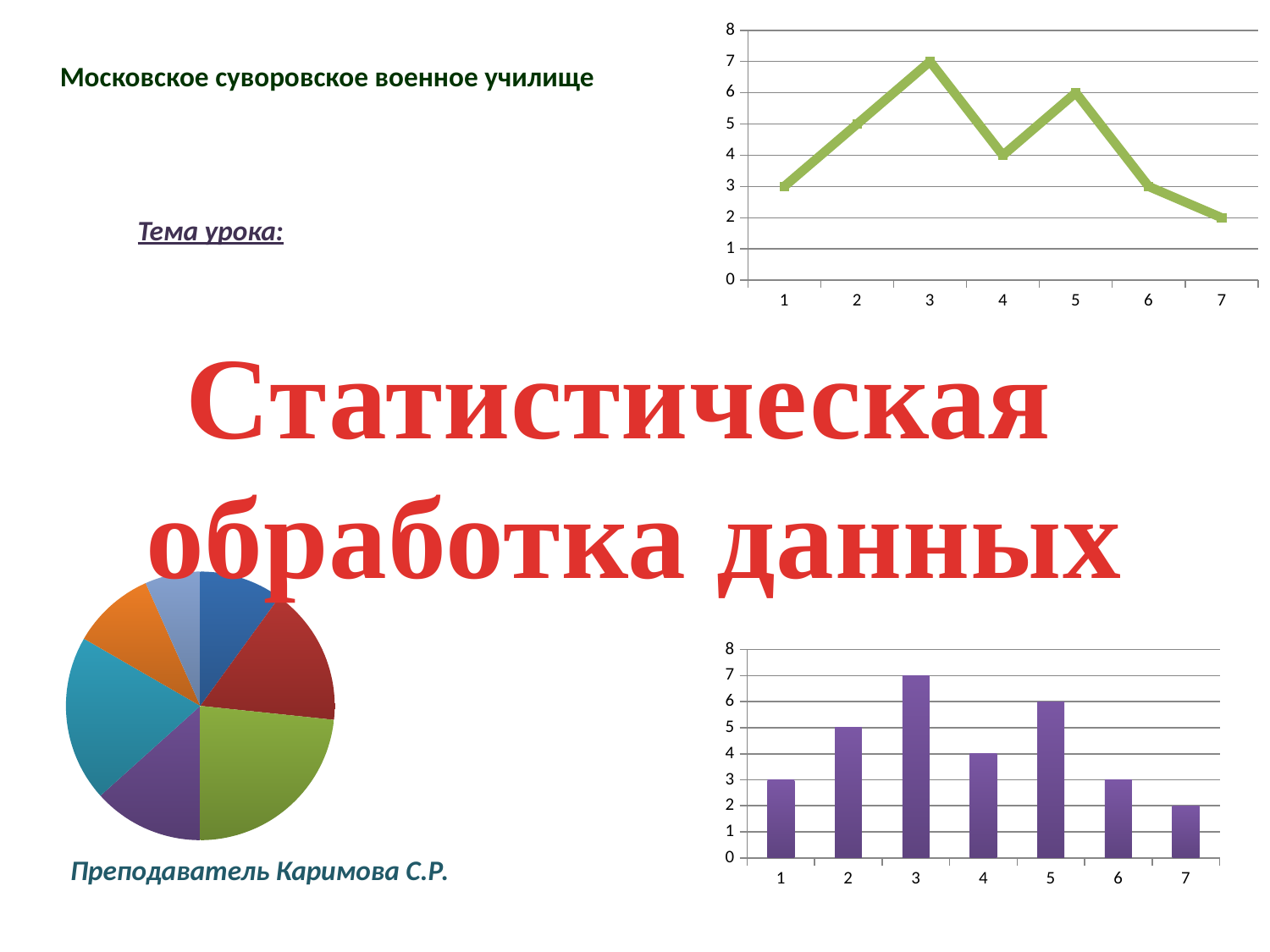
In the line chart at the top right, what is the value at point 5? 6 In the bar chart at the bottom right, what is the value for category 7? 2 In the line chart at the top right, which point has the lowest value? 7 How many slices does the pie chart at the bottom left have? 7 In the bar chart at the bottom right, what is the value for category 3? 7 In the bar chart at the bottom right, which category has the highest value? 3 What kind of chart is shown in the bottom right of the slide? bar chart How many categories are shown on the x axis of the bar chart at the bottom right? 7 What kind of chart is shown in the bottom left of the slide? pie chart In the line chart at the top right, which is larger, the value at point 2 or the value at point 6? point 2 In the bar chart at the bottom right, what is the difference between the values for category 3 and category 4? 3 What kind of chart is shown in the top right of the slide? line chart